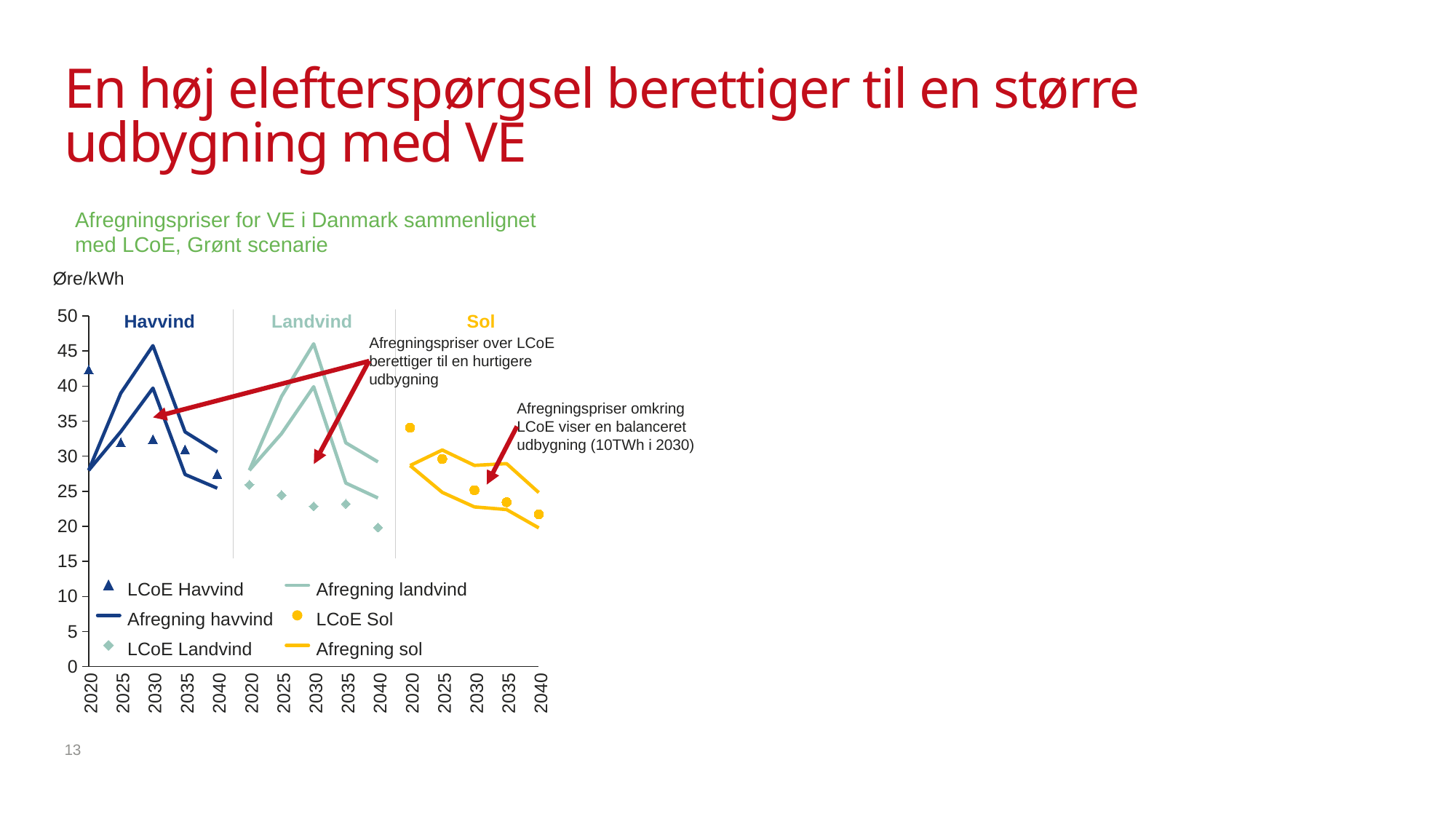
What unit is shown on the y axis of the chart? Øre/kWh How many years are plotted on the x axis within each panel of the chart? 5 What kind of chart is shown on the slide? Line chart Does the LCoE Landvind series rise or fall from 2020 to 2040? fall Which is larger in 2020: LCoE Havvind or LCoE Sol? LCoE Havvind Is the value for LCoE Sol in 2020 greater or less than 30? greater How many series does the chart legend list? 6 In which year is LCoE Sol at its highest? 2020 Is the value for LCoE Landvind in 2040 greater or less than 25? less Is the value for LCoE Havvind in 2020 greater or less than 40? greater What are the three panel headings shown across the top of the chart? Havvind, Landvind, Sol